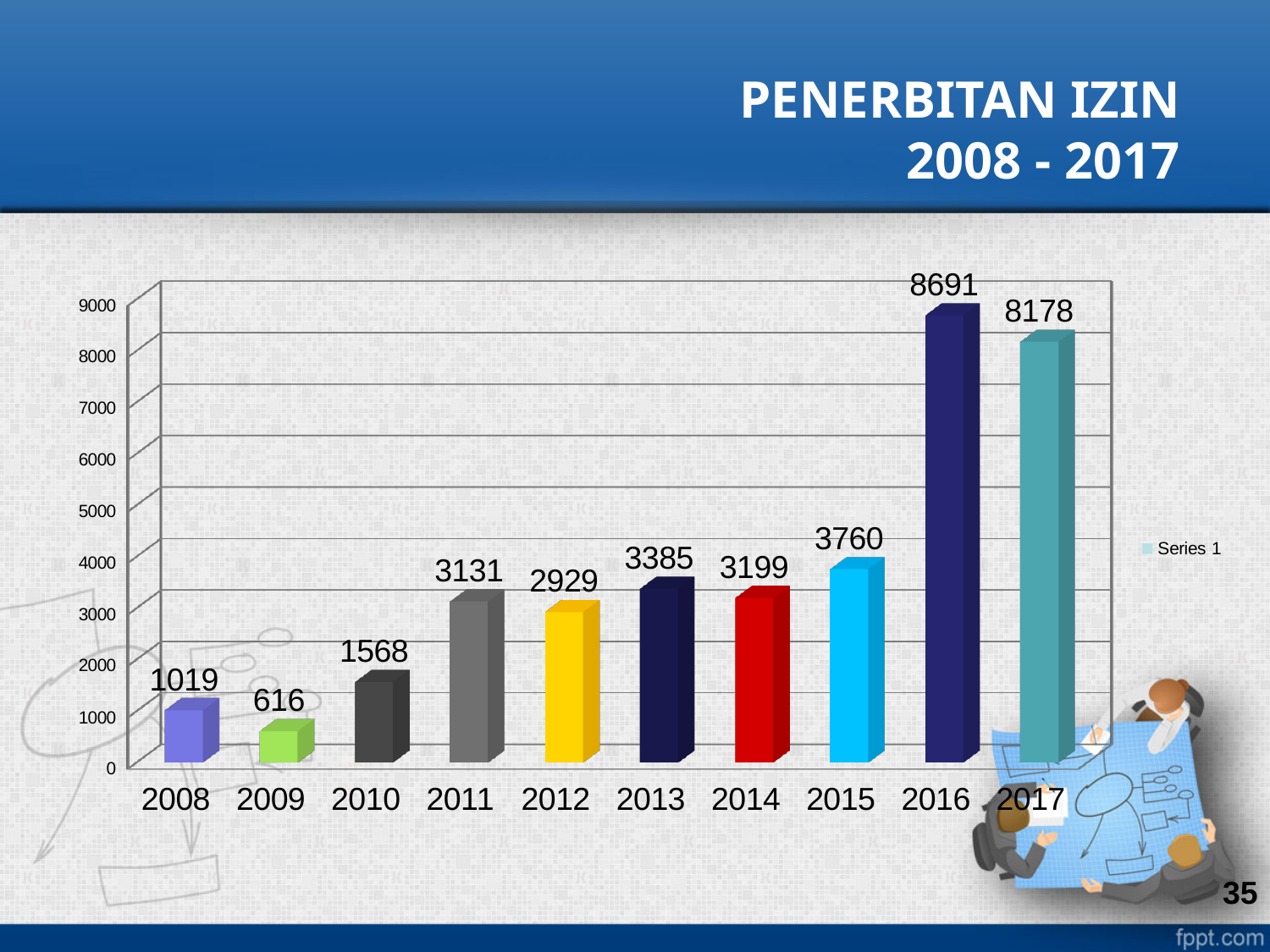
What is the value for 2016? 8691 Which year has the highest value? 2016 How many years are shown on the x axis? 10 Which is larger, the value for 2013 or the value for 2014? 2013 What is the title of the slide? PENERBITAN IZIN 2008 - 2017 What is the value for 2012? 2929 Which year has the lowest value? 2009 What is the difference between the values for 2016 and 2017? 513 Is the value for 2015 greater or less than 3000? greater How many series does the legend list? 1 What kind of chart is shown? bar chart What is the value for 2009? 616